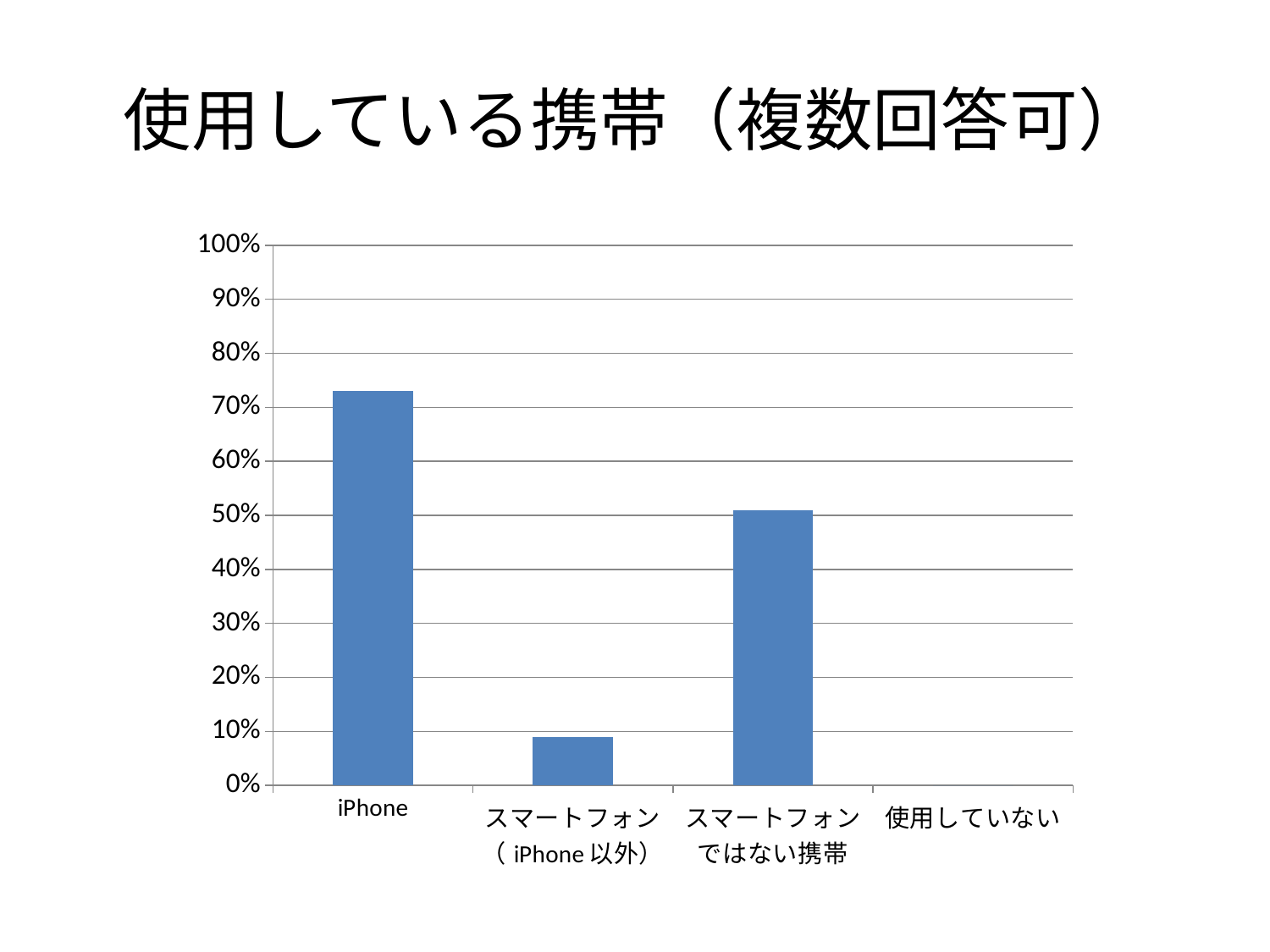
What is the title of the slide containing the chart? 使用している携帯（複数回答可） Is the value for スマートフォンではない携帯 greater or less than 60%? less Which category has the highest bar in the chart? iPhone Which is larger, the value for スマートフォン（iPhone以外） or the value for スマートフォンではない携帯? スマートフォンではない携帯 What kind of chart is shown on the slide? bar chart Is the value for iPhone greater or less than 70%? greater Is the value for iPhone greater or less than 80%? less How many categories are shown on the x axis of the chart? 4 Which is larger, the value for iPhone or the value for スマートフォンではない携帯? iPhone Which category has the lowest value in the chart? 使用していない